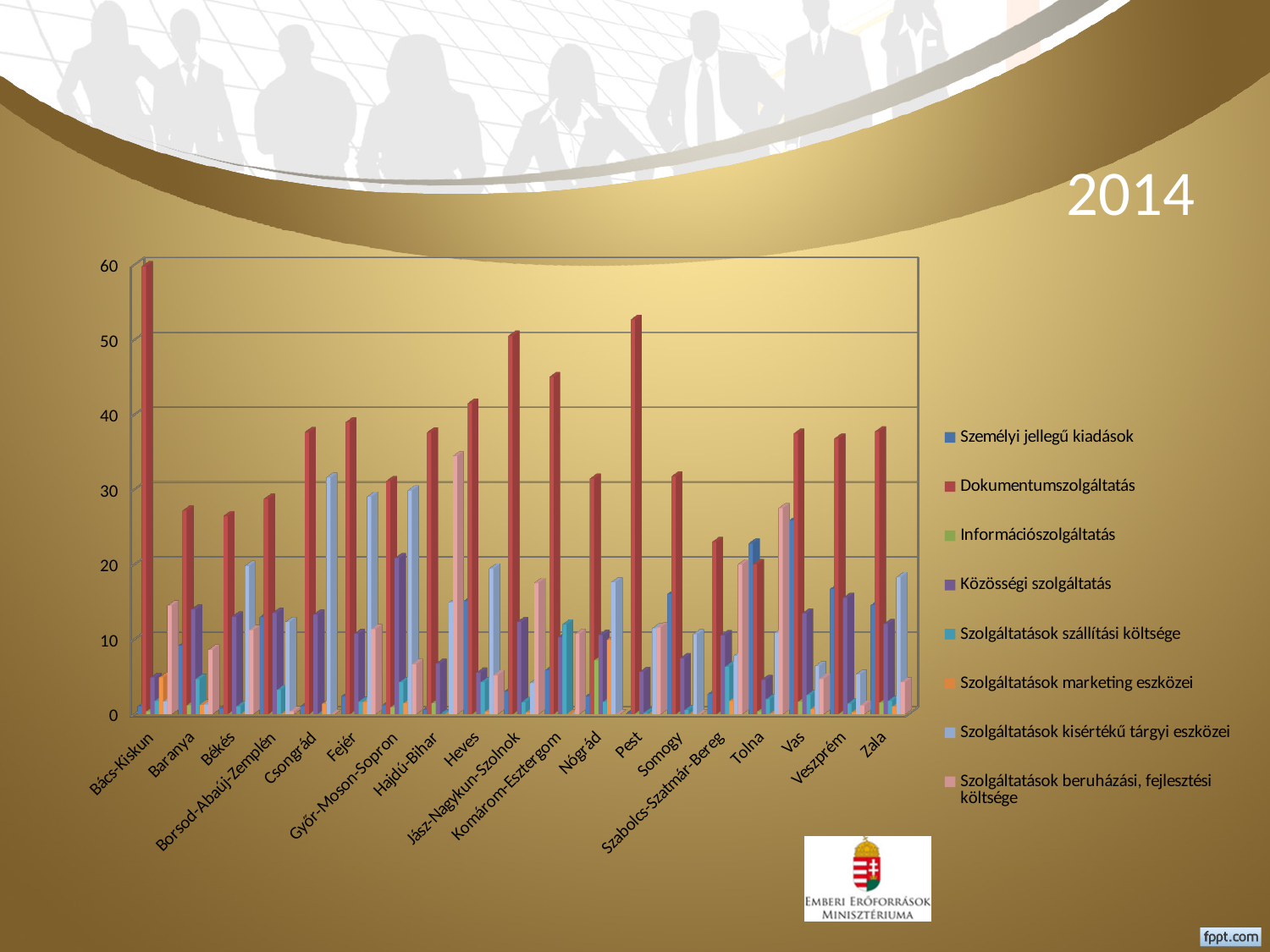
What year is shown as the title above the chart? 2014 Is the Dokumentumszolgáltatás value for Pest greater or less than 50? greater Which county has the highest Dokumentumszolgáltatás value? Bács-Kiskun What kind of chart is shown on the slide? bar chart Is the Szolgáltatások beruházási, fejlesztési költsége value for Heves greater or less than 30? less Which is larger, the Dokumentumszolgáltatás value for Bács-Kiskun or for Pest? Bács-Kiskun How many series does the chart's legend list? 8 Is the Személyi jellegű kiadások value for Tolna greater or less than 20? greater Which is larger, the Dokumentumszolgáltatás value for Jász-Nagykun-Szolnok or for Somogy? Jász-Nagykun-Szolnok How many counties (categories) are shown on the x axis of the chart? 19